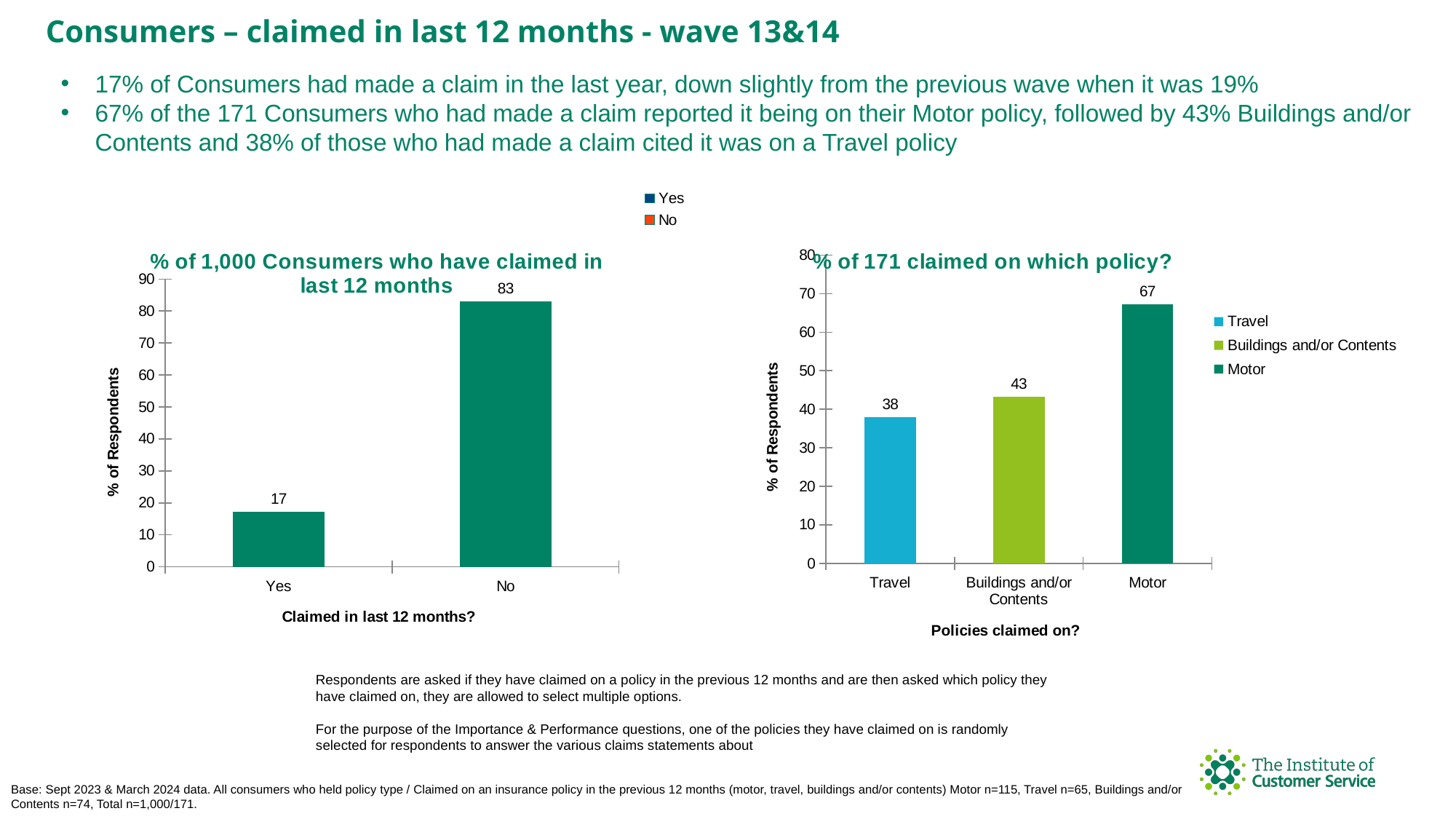
What kind of chart is the left chart '% of 1,000 Consumers who have claimed in last 12 months'? Bar chart In the left chart '% of 1,000 Consumers who have claimed in last 12 months', what is the value for 'No'? 83 In the right chart '% of 171 claimed on which policy?', what is the value for 'Buildings and/or Contents'? 43 In the right chart '% of 171 claimed on which policy?', what is the difference between the 'Motor' and 'Travel' values? 29 In the left chart '% of 1,000 Consumers who have claimed in last 12 months', what is the value for 'Yes'? 17 In the right chart '% of 171 claimed on which policy?', what is the value for 'Travel'? 38 In the right chart '% of 171 claimed on which policy?', how many policy categories are shown on the x axis? 3 In the right chart '% of 171 claimed on which policy?', which policy has the lowest value? Travel In the left chart '% of 1,000 Consumers who have claimed in last 12 months', what is the difference between the 'No' and 'Yes' values? 66 In the right chart '% of 171 claimed on which policy?', how many entries does the legend list? 3 In the left chart '% of 1,000 Consumers who have claimed in last 12 months', which category has the higher value? No In the right chart '% of 171 claimed on which policy?', which policy has the highest value? Motor